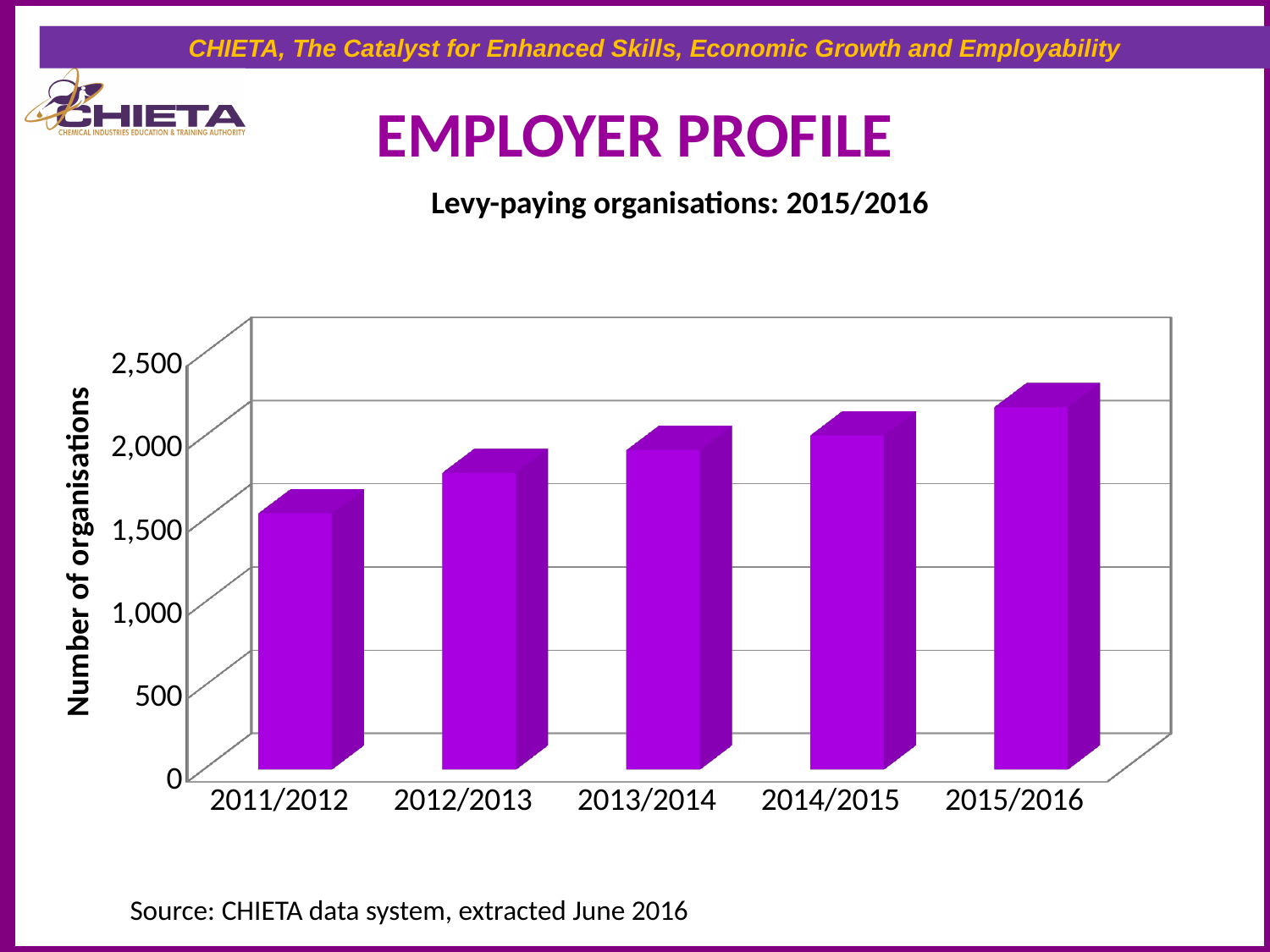
Is the value for 2015/2016 greater or less than 2,500? less How many financial years are shown on the x axis of the chart? 5 What is the label on the vertical axis of the chart? Number of organisations Is the value for 2015/2016 greater or less than 2,000? greater Do the values rise or fall from 2011/2012 to 2015/2016? rise Is the value for 2012/2013 greater or less than 1,500? greater What is the title of the chart? Levy-paying organisations: 2015/2016 Which year has the highest number of levy-paying organisations? 2015/2016 Which year has the lowest number of levy-paying organisations? 2011/2012 Which is larger, the value for 2014/2015 or the value for 2012/2013? 2014/2015 What kind of chart is shown on the slide? bar chart